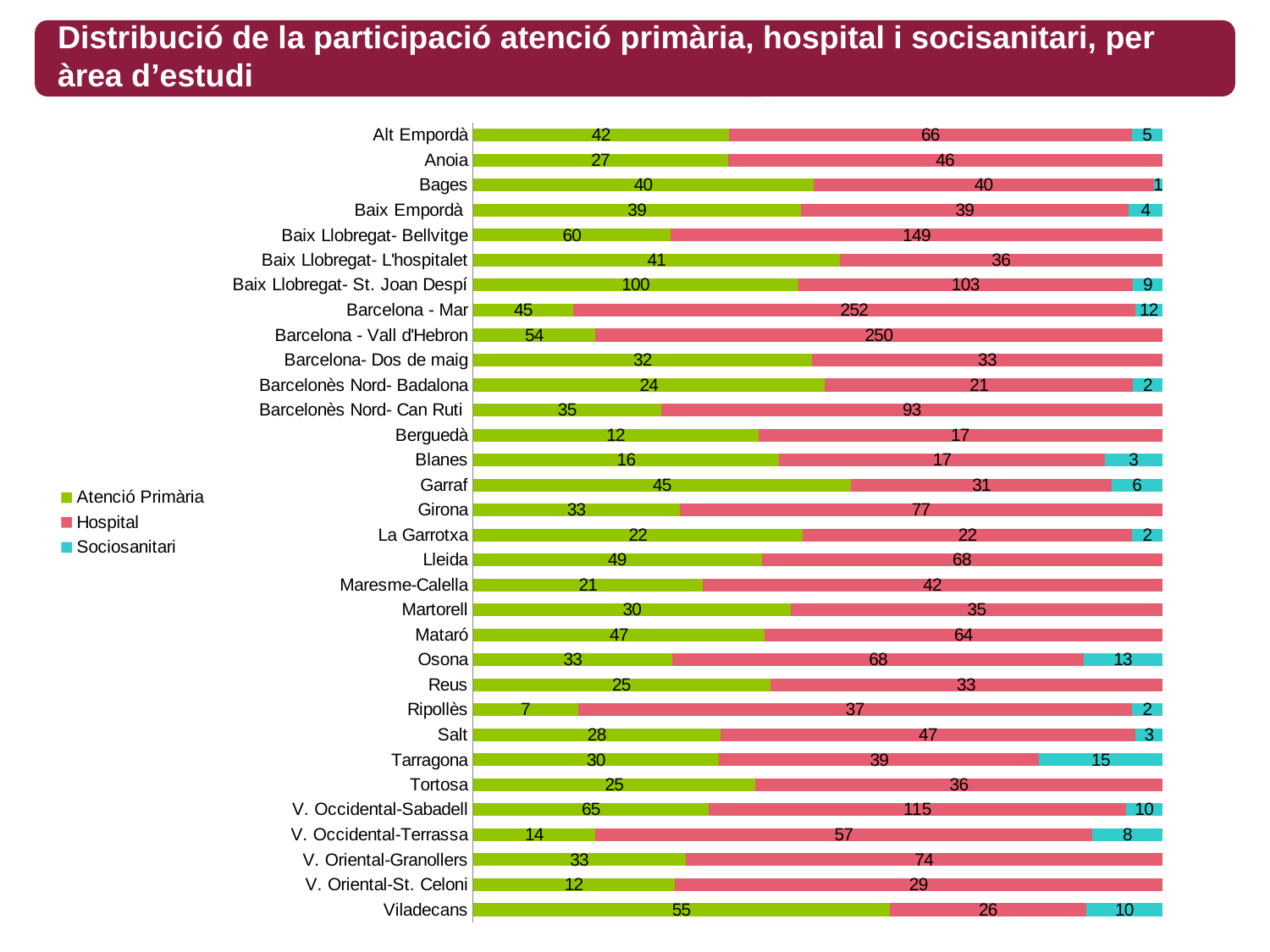
Which is larger for Viladecans, the Atenció Primària value or the Hospital value? Atenció Primària Which area has the highest Sociosanitari value? Tarragona What is the Hospital value for Barcelona - Mar? 252 What is the difference between the Hospital and Atenció Primària values for Baix Llobregat- Bellvitge? 89 What is the Sociosanitari value for Tarragona? 15 What is the total of the stacked bar for Alt Empordà? 113 What is the Atenció Primària value for Baix Llobregat- St. Joan Despí? 100 How many areas (categories) are shown in the chart? 32 What type of chart is shown on the slide? Stacked bar chart How many series does the legend list? 3 Which area has the lowest Atenció Primària value? Ripollès Which area has the highest Atenció Primària value? Baix Llobregat- St. Joan Despí